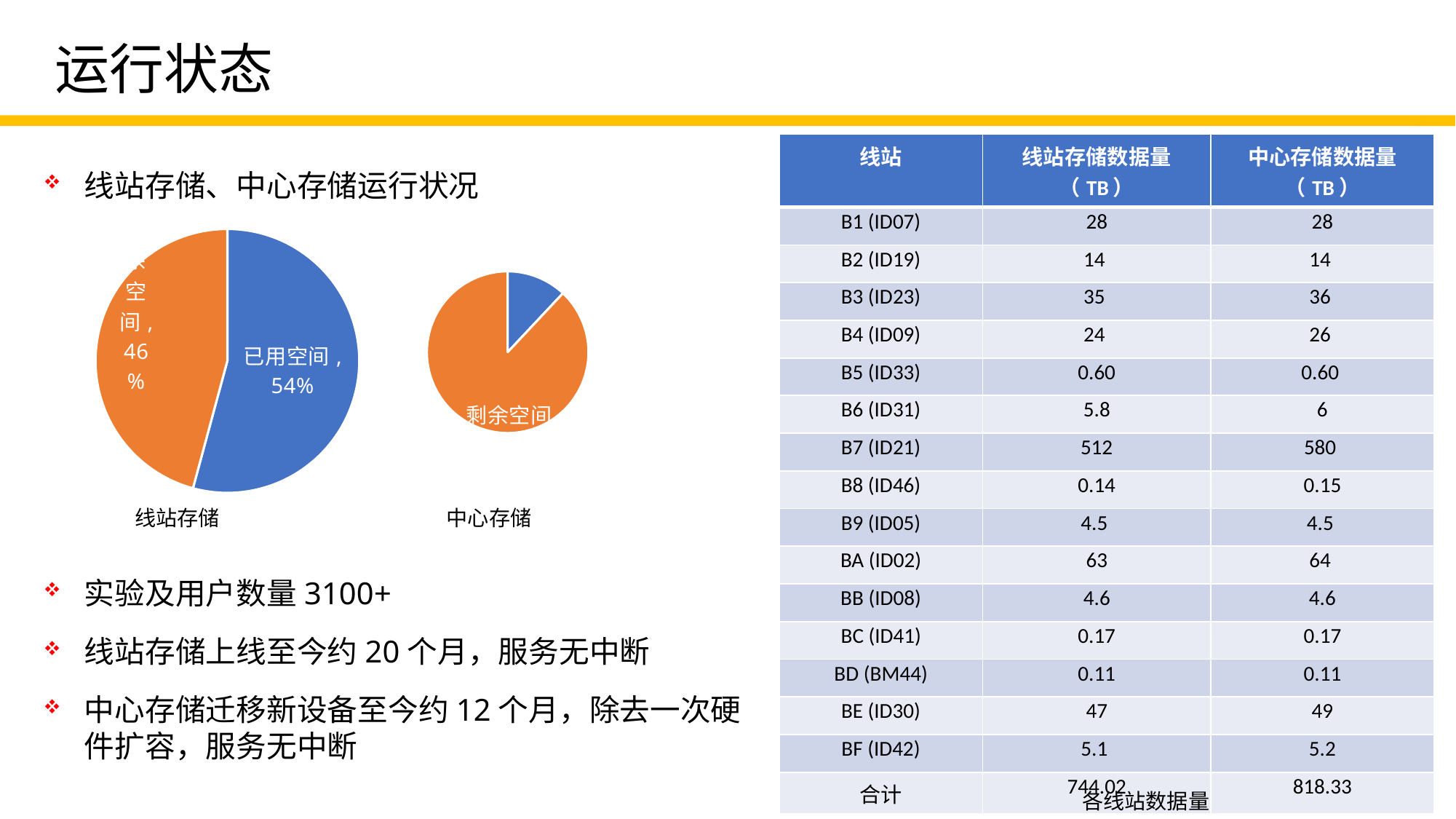
In the 线站存储 pie chart, what colour is the 已用空间 slice? blue In the 线站存储 pie chart, which slice is the smallest? 剩余空间 In the 线站存储 pie chart, what share is labelled for 已用空间? 54% In the 线站存储 pie chart, which slice is the largest? 已用空间 What kind of chart is the 中心存储 chart? pie chart What kind of chart is the 线站存储 chart? pie chart In the 线站存储 pie chart, which is larger, 已用空间 or 剩余空间? 已用空间 How many slices does the 中心存储 pie chart have? 2 In the 线站存储 pie chart, what share is labelled for 剩余空间? 46% In the 线站存储 pie chart, what is the difference in percentage points between 已用空间 and 剩余空间? 8 How many slices does the 线站存储 pie chart have? 2 In the 中心存储 pie chart, which labelled slice takes up most of the pie? 剩余空间